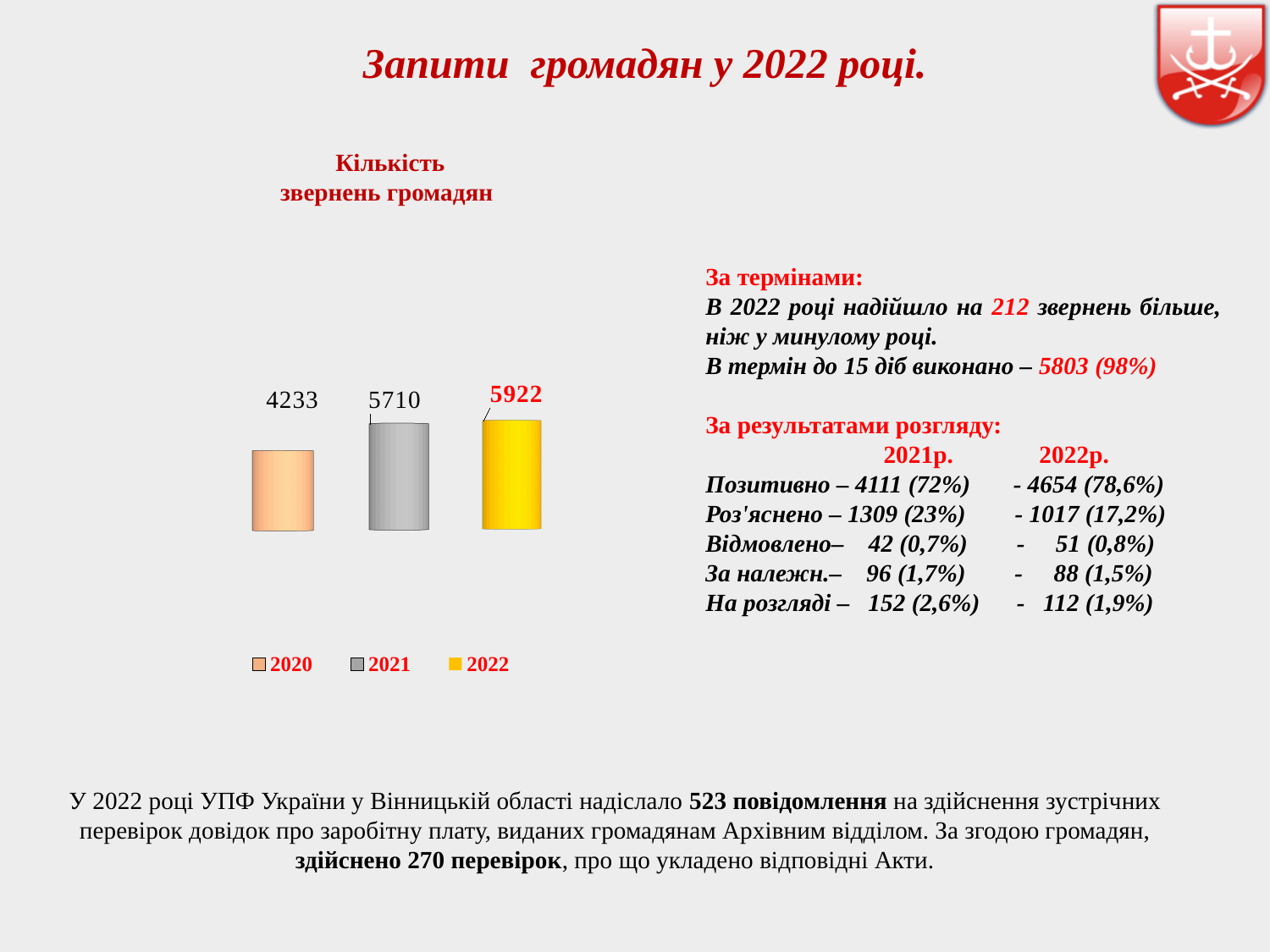
What is the difference between the values for 2022 and 2021 in the chart? 212 How many entries does the chart's legend list? 3 Which year has the highest value in the chart? 2022 What is the value shown for 2022 in the chart? 5922 What kind of chart is shown on the slide? bar chart What is the value shown for 2020 in the chart? 4233 How many bars are plotted in the chart? 3 Which year has the lowest value in the chart? 2020 Which is larger in the chart, the value for 2020 or the value for 2021? 2021 What is the difference between the values for 2021 and 2020 in the chart? 1477 What is the value shown for 2021 in the chart? 5710 Do the values in the chart rise or fall from 2020 to 2022? rise